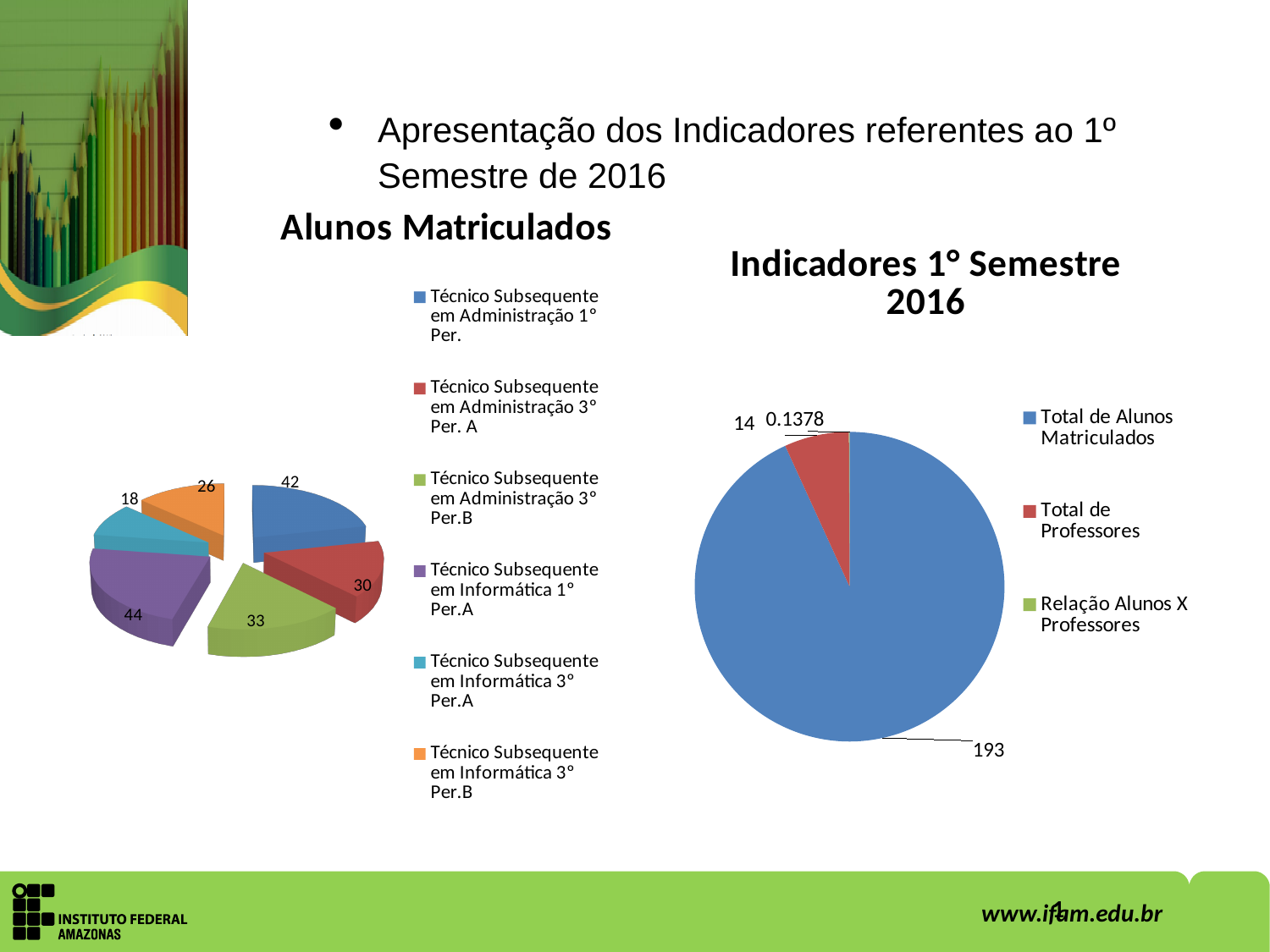
In the 'Indicadores 1° Semestre 2016' chart, what is the value for Total de Professores? 14 In the 'Indicadores 1° Semestre 2016' chart, what is the value for Relação Alunos X Professores? 0.1378 How many entries does the legend of the 'Indicadores 1° Semestre 2016' chart list? 3 What kind of chart is the 'Alunos Matriculados' chart? Pie chart How many categories does the 'Alunos Matriculados' chart show? 6 In the 'Indicadores 1° Semestre 2016' chart, which category has the highest value? Total de Alunos Matriculados In the 'Alunos Matriculados' chart, which category has the lowest value? Técnico Subsequente em Informática 3° Per.A In the 'Alunos Matriculados' chart, which category has the highest value? Técnico Subsequente em Informática 1° Per.A In the 'Alunos Matriculados' chart, what is the difference between Técnico Subsequente em Administração 1° Per. and Técnico Subsequente em Informática 3° Per.B? 16 In the 'Alunos Matriculados' chart, what is the value for Técnico Subsequente em Administração 3° Per. A? 30 In the 'Alunos Matriculados' chart, which is larger: Técnico Subsequente em Administração 3° Per.B or Técnico Subsequente em Administração 3° Per. A? Técnico Subsequente em Administração 3° Per.B In the 'Alunos Matriculados' chart, what is the value for Técnico Subsequente em Informática 1° Per.A? 44